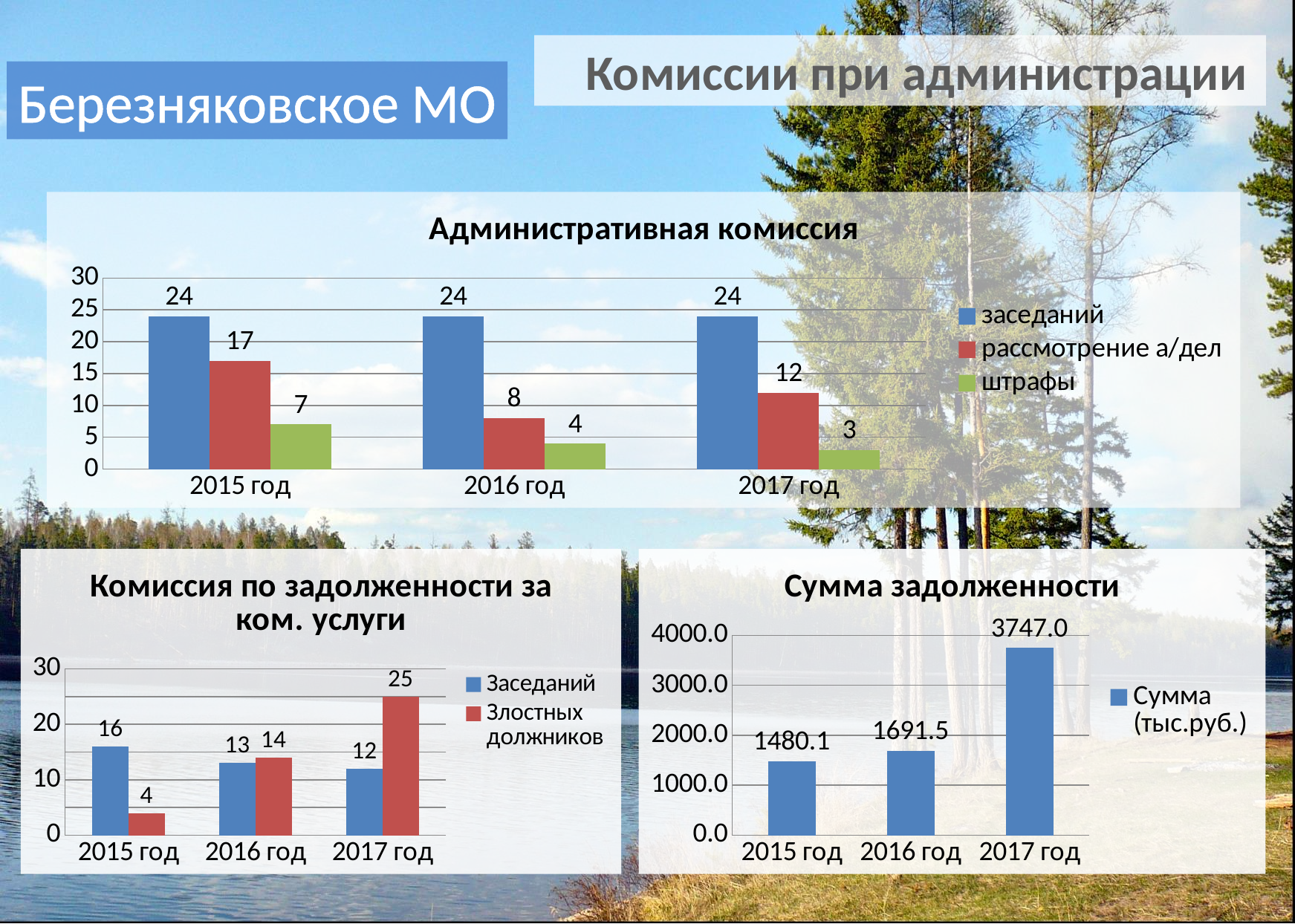
In the 'Сумма задолженности' chart, what is the difference between the values for 2017 год and 2015 год? 2266.9 In the 'Комиссия по задолженности за ком. услуги' chart, which year has the lowest value for 'Заседаний'? 2017 год What type of chart is the 'Сумма задолженности' chart? bar chart In the 'Комиссия по задолженности за ком. услуги' chart, what is the value of 'Злостных должников' for 2017 год? 25 In the 'Сумма задолженности' chart, what is the value for 2016 год? 1691.5 In the 'Административная комиссия' chart, do the 'штрафы' values rise or fall from 2015 год to 2017 год? fall In the 'Административная комиссия' chart, what is the value of 'рассмотрение а/дел' for 2015 год? 17 In the 'Административная комиссия' chart, what is the value of 'штрафы' for 2017 год? 3 In the 'Сумма задолженности' chart, which year has the highest value? 2017 год In the 'Административная комиссия' chart, what is the difference between 'рассмотрение а/дел' in 2015 год and 2016 год? 9 In the 'Комиссия по задолженности за ком. услуги' chart, which is larger for 2016 год: 'Заседаний' or 'Злостных должников'? Злостных должников In the 'Административная комиссия' chart, how many series does the legend list? 3